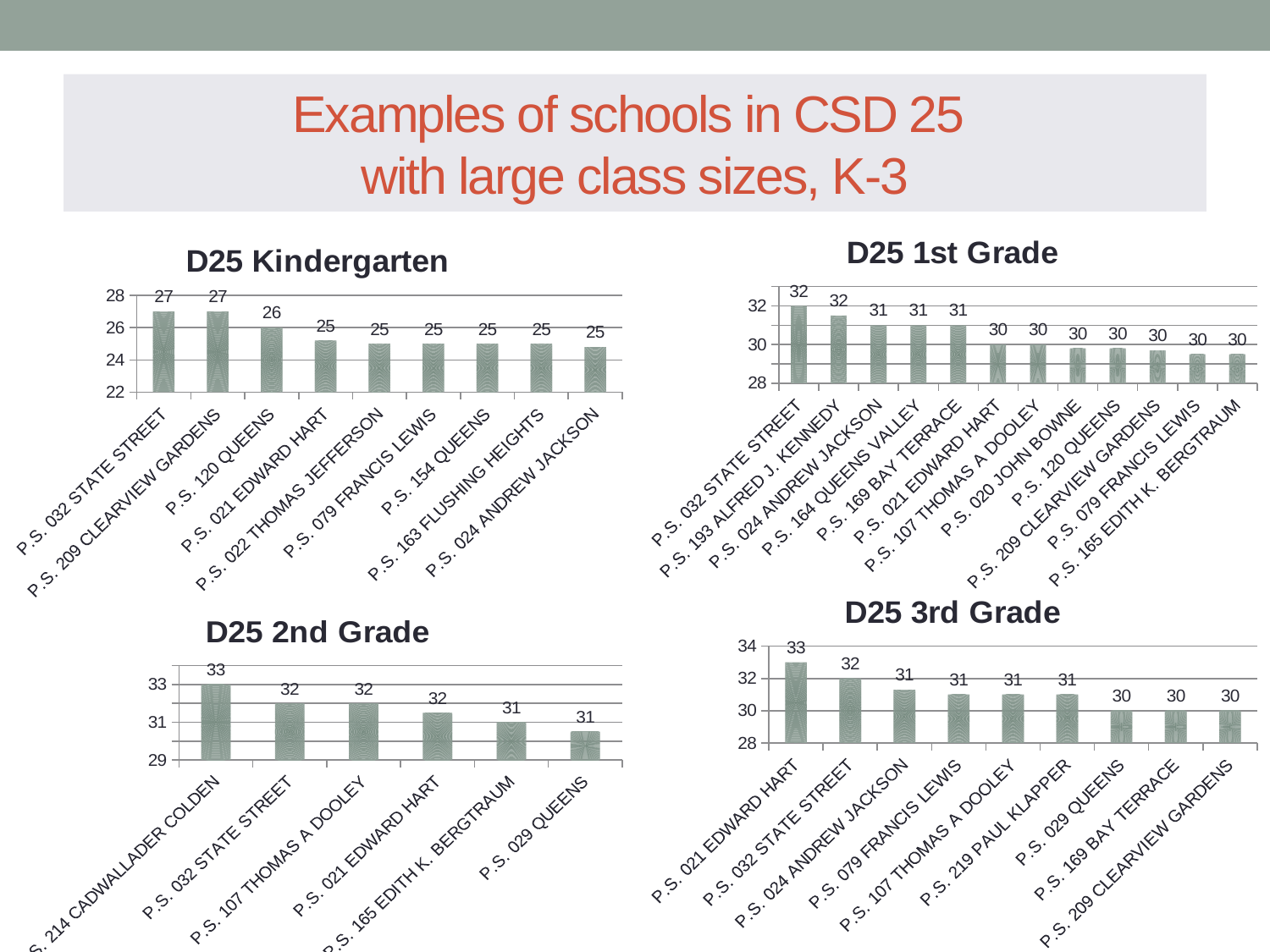
On the D25 3rd Grade chart, is the value for P.S. 032 STATE STREET greater or less than 30? greater On the D25 2nd Grade chart, what is the value for P.S. 165 EDITH K. BERGTRAUM? 31 How many schools are shown on the D25 2nd Grade chart? 6 On the D25 3rd Grade chart, do the values rise or fall from left to right? fall On the D25 Kindergarten chart, what is the difference between the values for P.S. 032 STATE STREET and P.S. 120 QUEENS? 1 On the D25 Kindergarten chart, what is the value for P.S. 120 QUEENS? 26 How many schools are shown on the D25 1st Grade chart? 12 On the D25 3rd Grade chart, which school has the highest value? P.S. 021 EDWARD HART On the D25 1st Grade chart, which is larger, the value for P.S. 032 STATE STREET or the value for P.S. 020 JOHN BOWNE? P.S. 032 STATE STREET What kind of chart is the D25 Kindergarten chart? bar chart On the D25 1st Grade chart, what is the value for P.S. 164 QUEENS VALLEY? 31 On the D25 3rd Grade chart, what is the difference between the values for P.S. 021 EDWARD HART and P.S. 029 QUEENS? 3